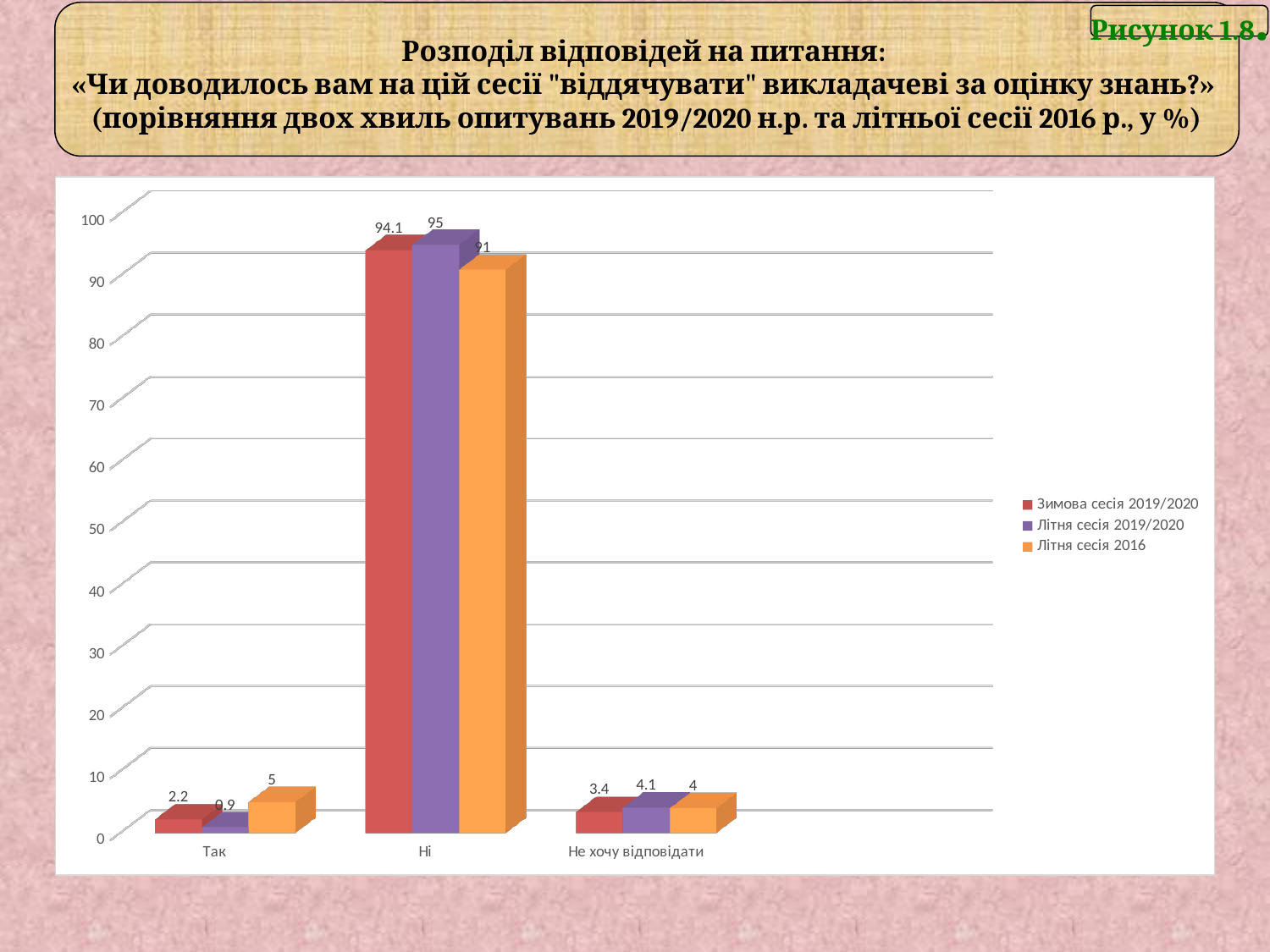
Which category has the highest value in the "Літня сесія 2019/2020" series? Ні What kind of chart is shown on the slide? bar chart What is the value for "Ні" in the "Літня сесія 2016" series? 91 Which category has the lowest value in the "Зимова сесія 2019/2020" series? Так What is the value for "Не хочу відповідати" in the "Літня сесія 2019/2020" series? 4.1 How many categories are shown on the x axis? 3 What is the difference between the "Літня сесія 2019/2020" and "Зимова сесія 2019/2020" values for "Ні"? 0.9 Is the value for "Ні" in the "Літня сесія 2016" series greater or less than 90? greater For "Так", which series has the larger value: "Літня сесія 2016" or "Зимова сесія 2019/2020"? Літня сесія 2016 How many series does the legend list? 3 What is the value for "Так" in the "Зимова сесія 2019/2020" series? 2.2 Which series is shown in orange in the legend? Літня сесія 2016